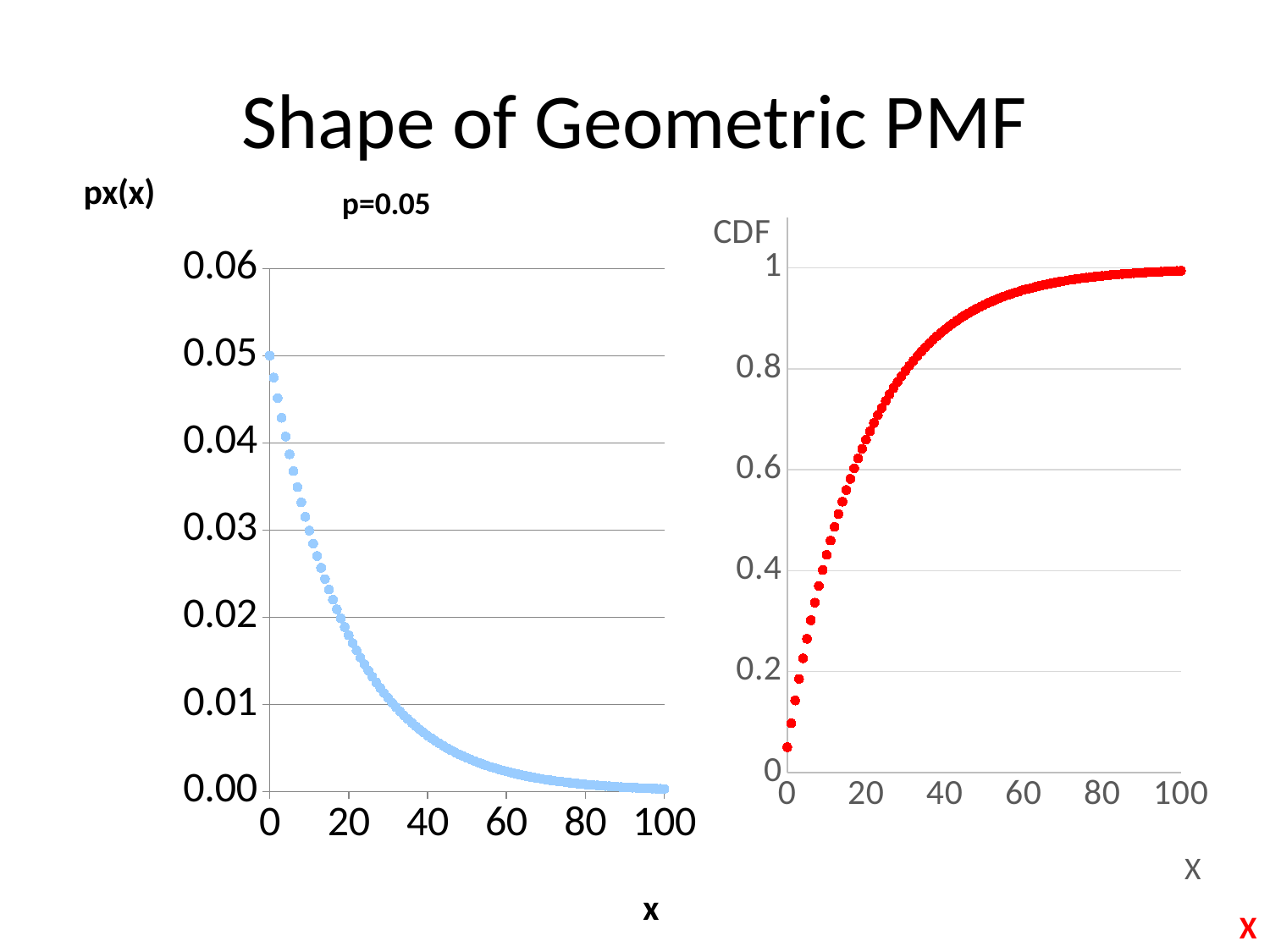
In the right chart (CDF), is the value at X = 40 greater or less than 0.8? greater What kind of chart is the left chart (px(x))? scatter chart What is the title of the slide? Shape of Geometric PMF In the right chart (CDF), do the values rise or fall as X increases? rise In the left chart (px(x)), do the values rise or fall as x increases? fall In the right chart (CDF), at which X value is the plotted value lowest? 0 In the left chart (px(x)), what is the value at x = 0? 0.05 In the right chart (CDF), is the value at X = 20 greater or less than 0.6? greater In the left chart (px(x)), at which x value is the plotted value highest? 0 What value of p is stated for the left chart (px(x))? p=0.05 In the left chart (px(x)), is the value at x = 40 greater or less than 0.01? less What kind of chart is the right chart (CDF)? scatter chart